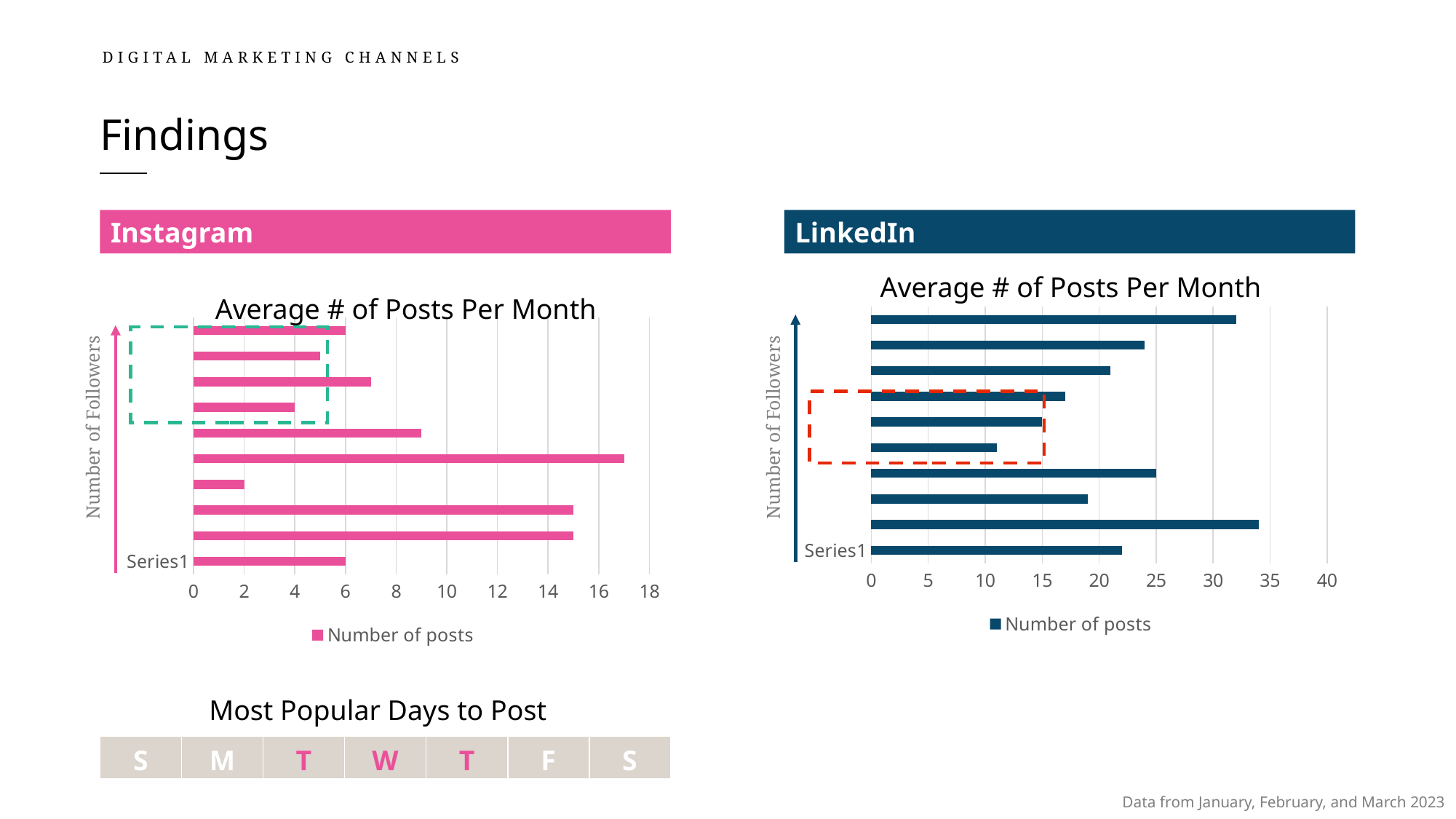
How many series does the legend of the Instagram chart list? 1 How many series does the legend of the LinkedIn chart list? 1 In the LinkedIn chart, how many bars are plotted? 10 Which chart has the larger value for the bar labelled Series1, the Instagram chart or the LinkedIn chart? LinkedIn chart What legend entry is shown under the LinkedIn chart? Number of posts In the Instagram chart, what is the value of the bar labelled Series1? 6 In the Instagram chart, is the longest bar greater or less than 16? greater In the LinkedIn chart, is the value of the bar labelled Series1 greater or less than 20? greater What kind of chart is the LinkedIn "Average # of Posts Per Month" chart? bar chart What kind of chart is the Instagram "Average # of Posts Per Month" chart? bar chart In the Instagram chart, how many bars are plotted? 10 In the LinkedIn chart, is the longest bar greater or less than 30? greater